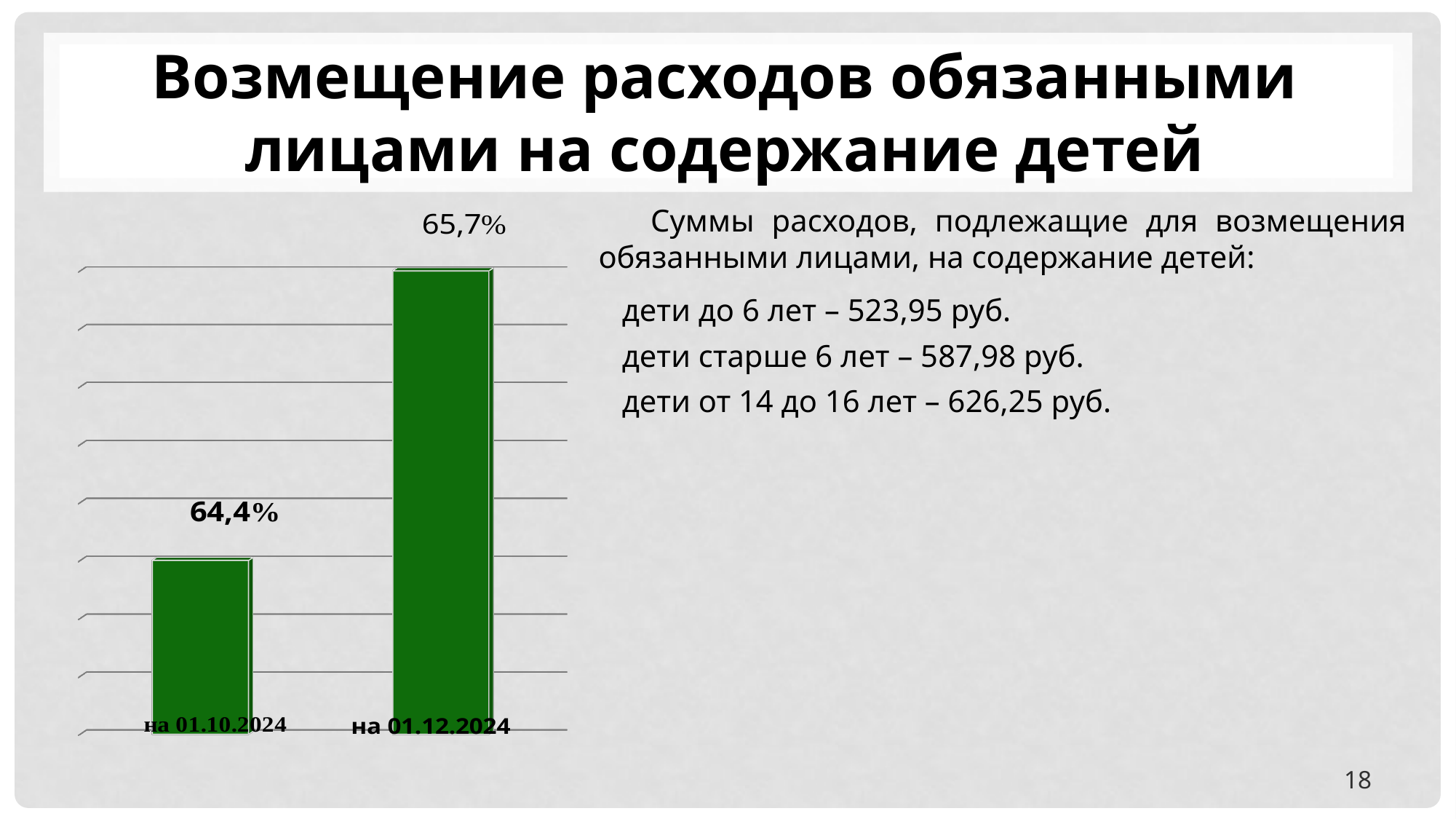
What is the value for на 01.12.2024? 65,7% How many bars are shown in the chart? 2 Which is larger, the value for на 01.10.2024 or the value for на 01.12.2024? на 01.12.2024 What is the value for на 01.10.2024? 64,4% What kind of chart is shown on the slide? bar chart What is the difference between the values for на 01.12.2024 and на 01.10.2024? 1,3% Do the values rise or fall from на 01.10.2024 to на 01.12.2024? rise Which category has the lowest value? на 01.10.2024 What colour are the bars in the chart? green Which category has the highest value? на 01.12.2024